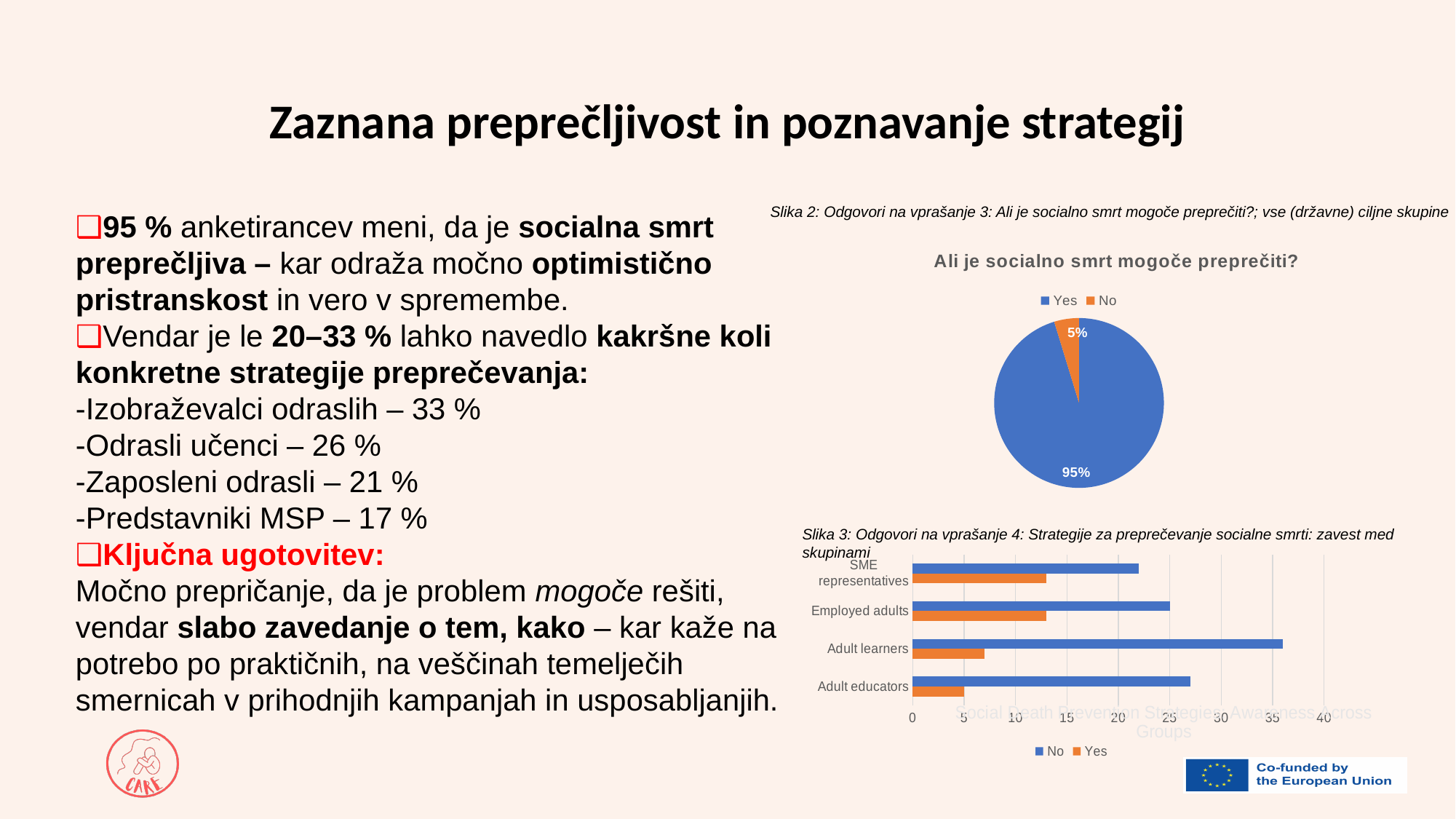
How many series does the legend of the bar chart at the bottom right of the slide list? 2 In the bar chart at the bottom right of the slide, is the Yes value for Adult educators greater or less than 10? less In the pie chart 'Ali je socialno smrt mogoče preprečiti?', what percentage of respondents answered Yes? 95% In the bar chart at the bottom right of the slide, is the No value for Adult learners greater or less than 30? greater In the bar chart at the bottom right of the slide, which group has the larger Yes value, SME representatives or Adult educators? SME representatives In the bar chart at the bottom right of the slide, which group has the highest value for the No series? Adult learners What kind of chart is the chart titled 'Ali je socialno smrt mogoče preprečiti?'? Pie chart How many groups (categories) are shown in the bar chart at the bottom right of the slide? 4 In the pie chart 'Ali je socialno smrt mogoče preprečiti?', what share of the pie does the No slice take? 5% What kind of chart is the chart at the bottom right of the slide (Slika 3)? Bar chart How many entries does the legend of the pie chart 'Ali je socialno smrt mogoče preprečiti?' list? 2 In the pie chart 'Ali je socialno smrt mogoče preprečiti?', which answer has the larger slice, Yes or No? Yes